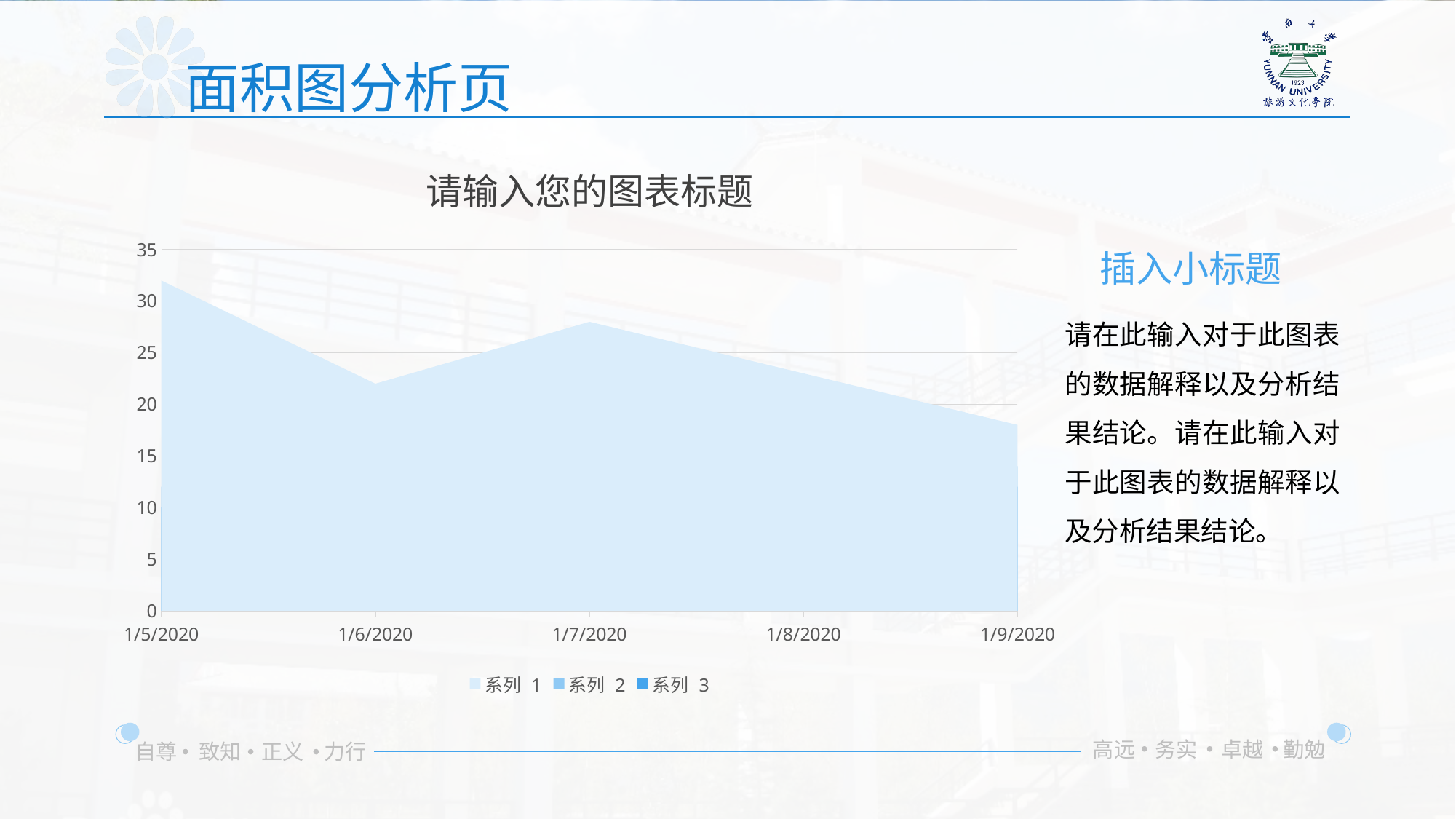
Which date has the highest value? 1/5/2020 How many dates are shown on the x axis? 5 What is the title of the chart? 请输入您的图表标题 Is the value for 1/6/2020 greater or less than 25? less How many series does the legend list? 3 Which date has the lowest value? 1/9/2020 Does the value at the last date (1/9/2020) end higher or lower than at the first date (1/5/2020)? lower Is the value for 1/9/2020 greater or less than 20? less Is the value for 1/5/2020 greater or less than 30? greater Which is larger, the value for 1/7/2020 or the value for 1/9/2020? 1/7/2020 What kind of chart is shown on the slide? Area chart